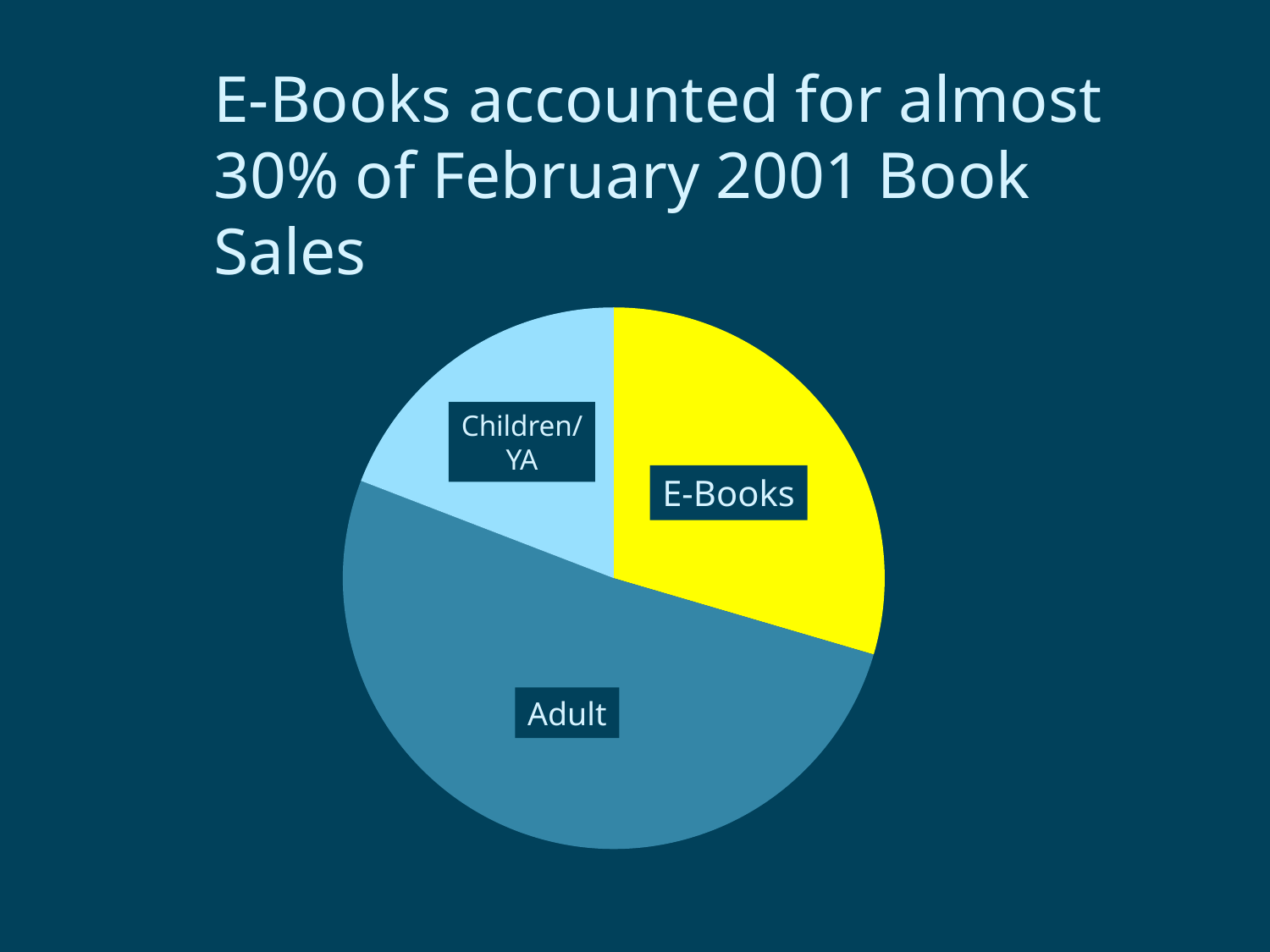
Which category has the smallest slice of the pie chart? Children/YA Which slice is larger, E-Books or Children/YA? E-Books Which category has the largest slice of the pie chart? Adult How many slices does the pie chart have? 3 What kind of chart is shown on the slide? pie chart What colour is the E-Books slice of the pie chart? yellow What is the title of the slide containing the pie chart? E-Books accounted for almost 30% of February 2001 Book Sales Which slice is smaller, Adult or Children/YA? Children/YA Which slice is larger, Adult or E-Books? Adult